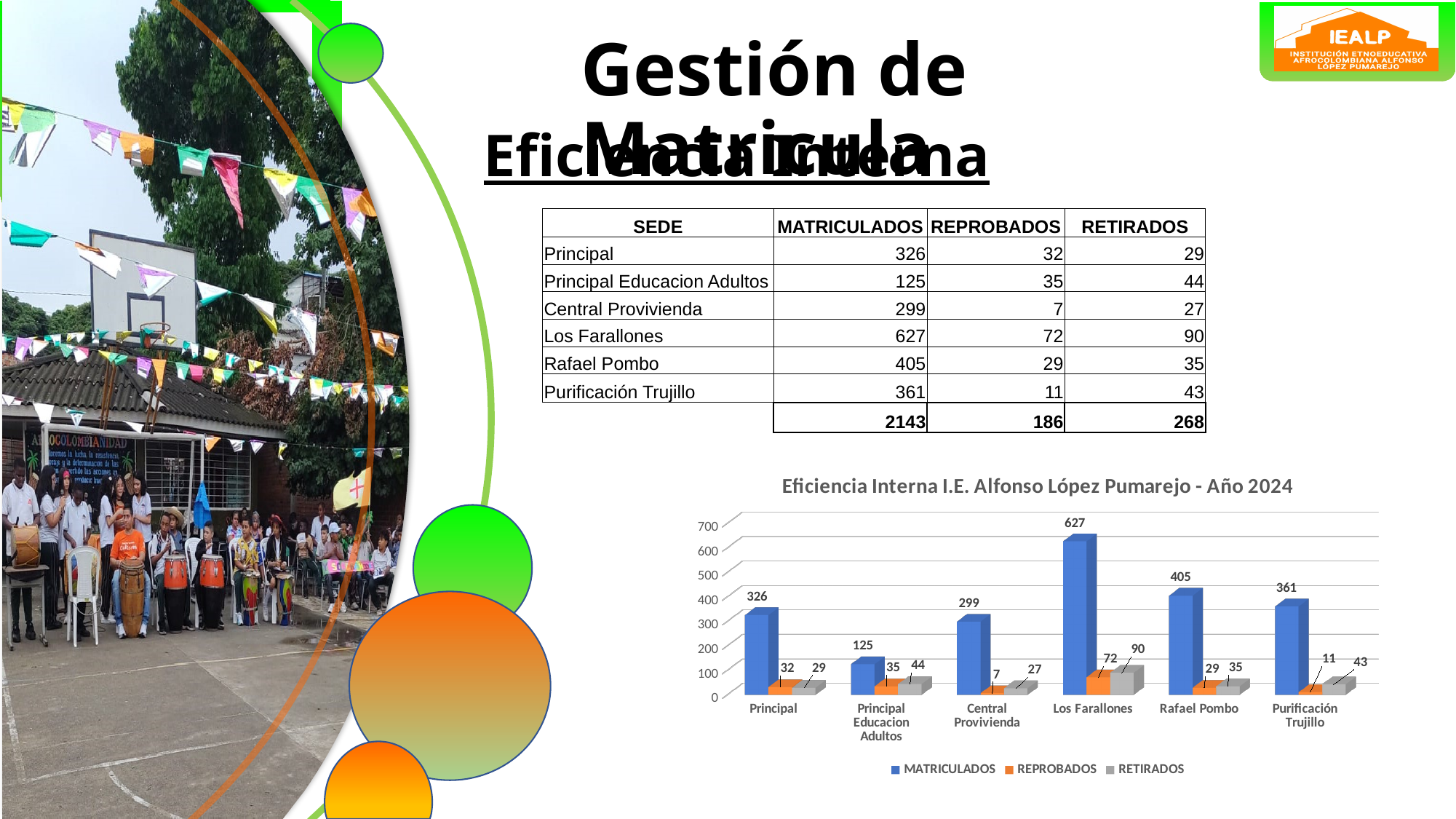
Which sede has the highest MATRICULADOS value? Los Farallones Is the MATRICULADOS value for Central Provivienda greater or less than 200? greater What is the REPROBADOS value for Central Provivienda? 7 Which is larger, the RETIRADOS value for Principal or the RETIRADOS value for Rafael Pombo? Rafael Pombo How many series does the chart legend list? 3 What is the difference between the MATRICULADOS values for Rafael Pombo and Purificación Trujillo? 44 What is the RETIRADOS value for Principal Educacion Adultos? 44 Which sede has the lowest MATRICULADOS value? Principal Educacion Adultos How many sedes (categories) are shown on the x axis of the chart? 6 What kind of chart is shown on the slide? bar chart What is the MATRICULADOS value for Los Farallones? 627 What is the title of the chart? Eficiencia Interna I.E. Alfonso López Pumarejo - Año 2024